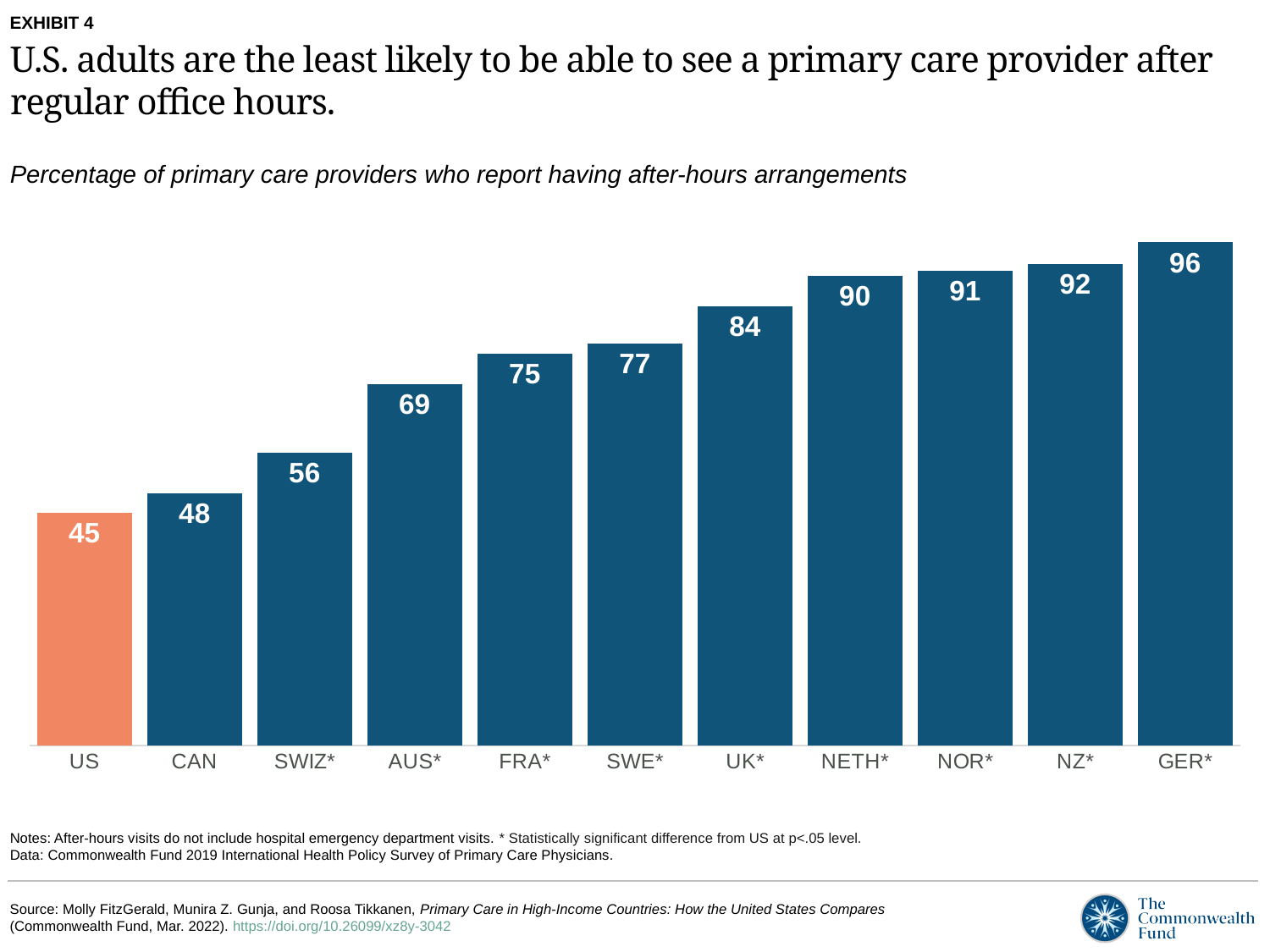
What is the value for AUS*? 69 Which country has the lowest value? US Do the values rise or fall from left to right along the x axis? rise How many countries are shown in the chart? 11 What is the difference between the values for SWE* and FRA*? 2 What is the difference between the values for GER* and US? 51 Which country has the highest value? GER* Which is larger, the value for CAN or the value for SWIZ*? SWIZ* Which bar is shown in a different colour (orange) from the others? US What kind of chart is this? bar chart What is the value for US? 45 What is the value for NETH*? 90